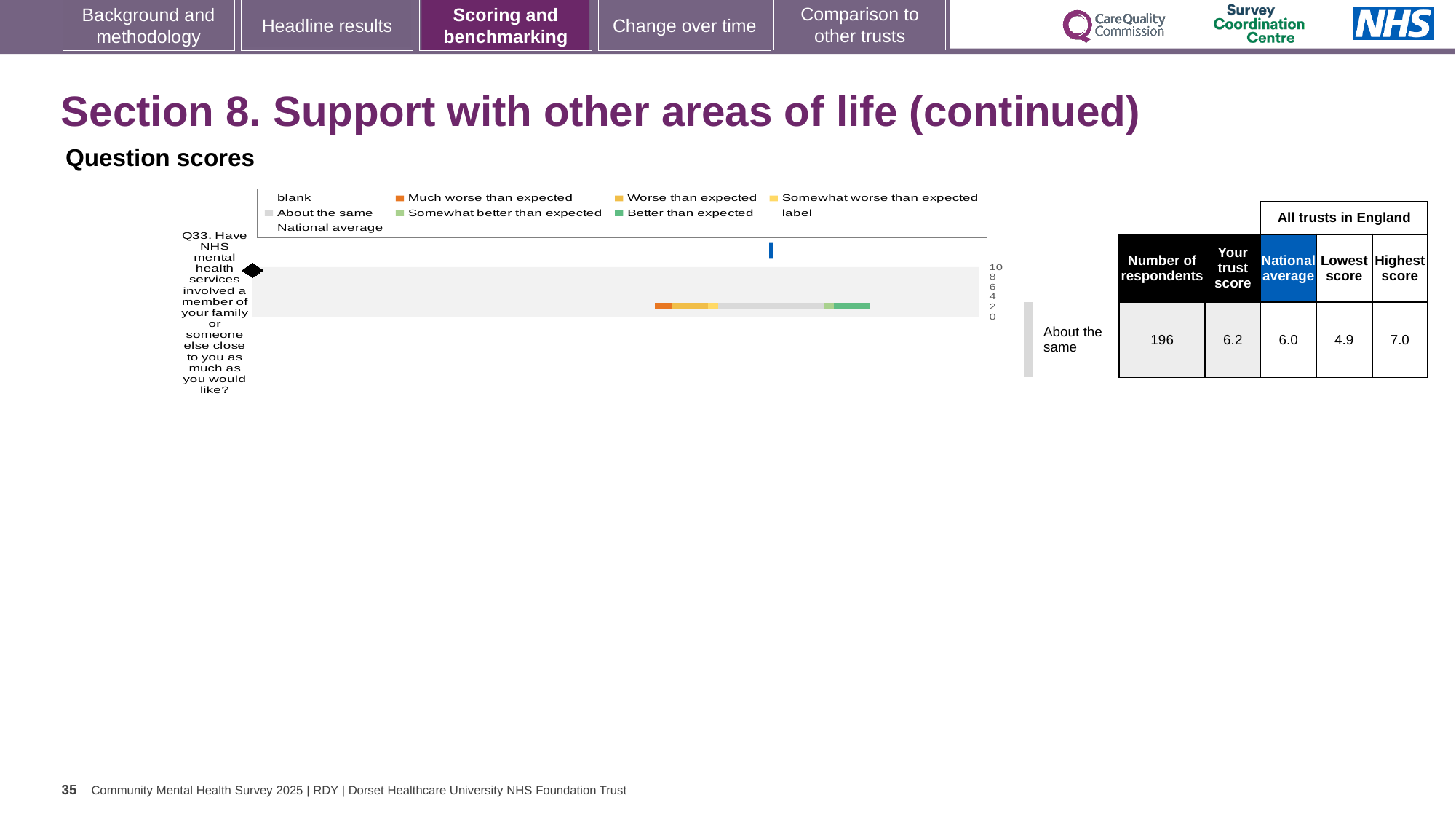
Which is larger for Q33, the trust's score or the national average? the trust's score What benchmark category is the trust's Q33 score placed in? About the same What is the trust's score for Q33 according to the table next to the chart? 6.2 What is the national average score for Q33? 6.0 How many respondents answered Q33? 196 What is the highest score among all trusts in England for Q33? 7.0 How many entries does the chart legend list? 9 Which question number is plotted in the chart? Q33 What is the difference between the trust's score and the national average for Q33? 0.2 How many questions (categories) are plotted in the chart? 1 What kind of chart is shown on the slide? bar chart What is the lowest score among all trusts in England for Q33? 4.9